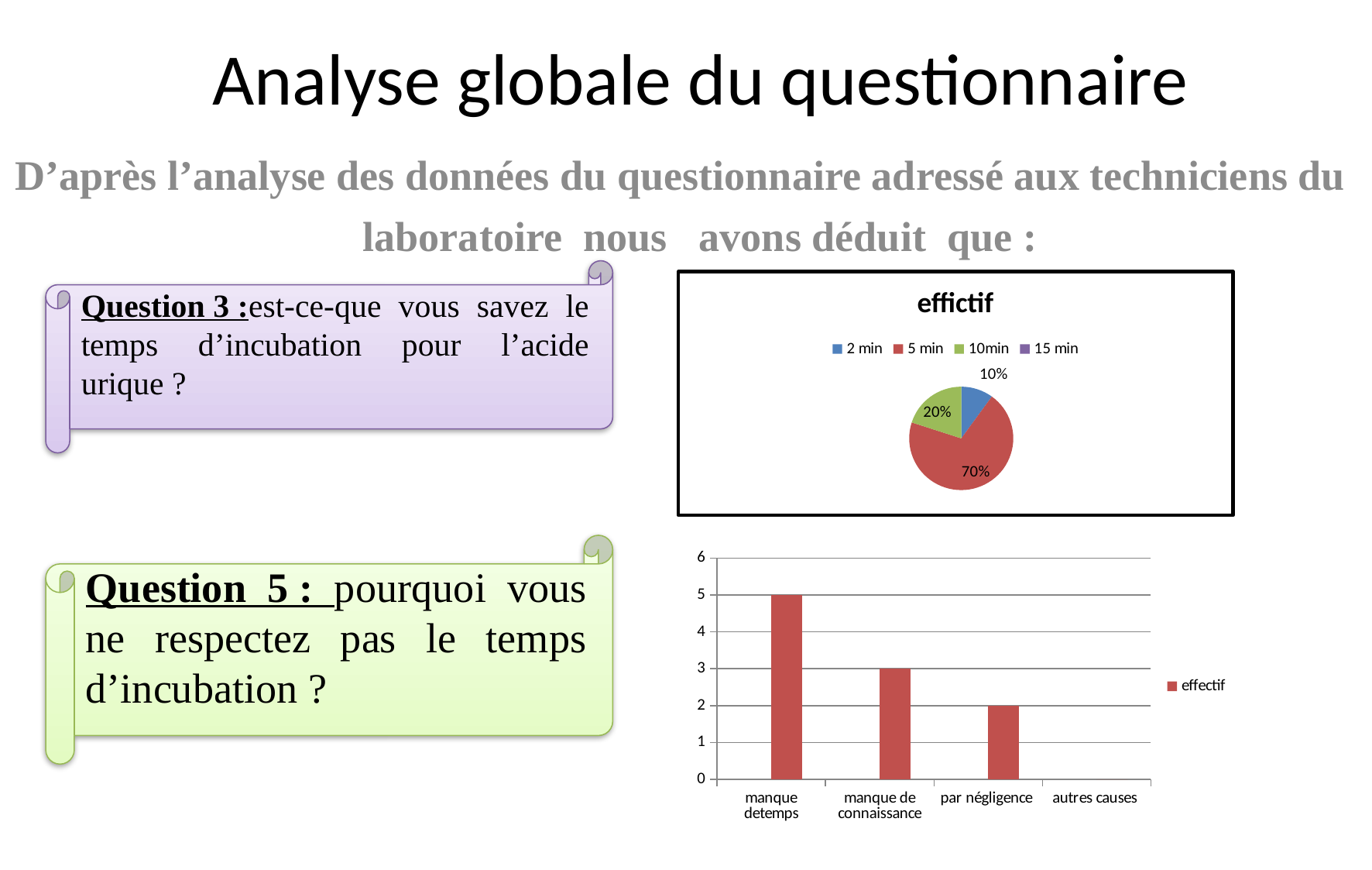
In the bar chart at the bottom right, what is the value for "manque detemps"? 5 In the pie chart titled "effictif", what share does the 5 min slice have? 70% In the bar chart at the bottom right, what is the value for "par négligence"? 2 In the pie chart titled "effictif", which category has the largest slice? 5 min In the pie chart titled "effictif", how many entries does the legend list? 4 In the pie chart titled "effictif", what share does the 2 min slice have? 10% What kind of chart is the chart titled "effictif"? pie chart In the bar chart at the bottom right, what is the difference between "manque detemps" and "par négligence"? 3 In the bar chart at the bottom right, what is the value for "manque de connaissance"? 3 In the pie chart titled "effictif", what share does the 10min slice have? 20% In the bar chart at the bottom right, which category has the highest value? manque detemps In the bar chart at the bottom right, how many categories are shown on the x axis? 4